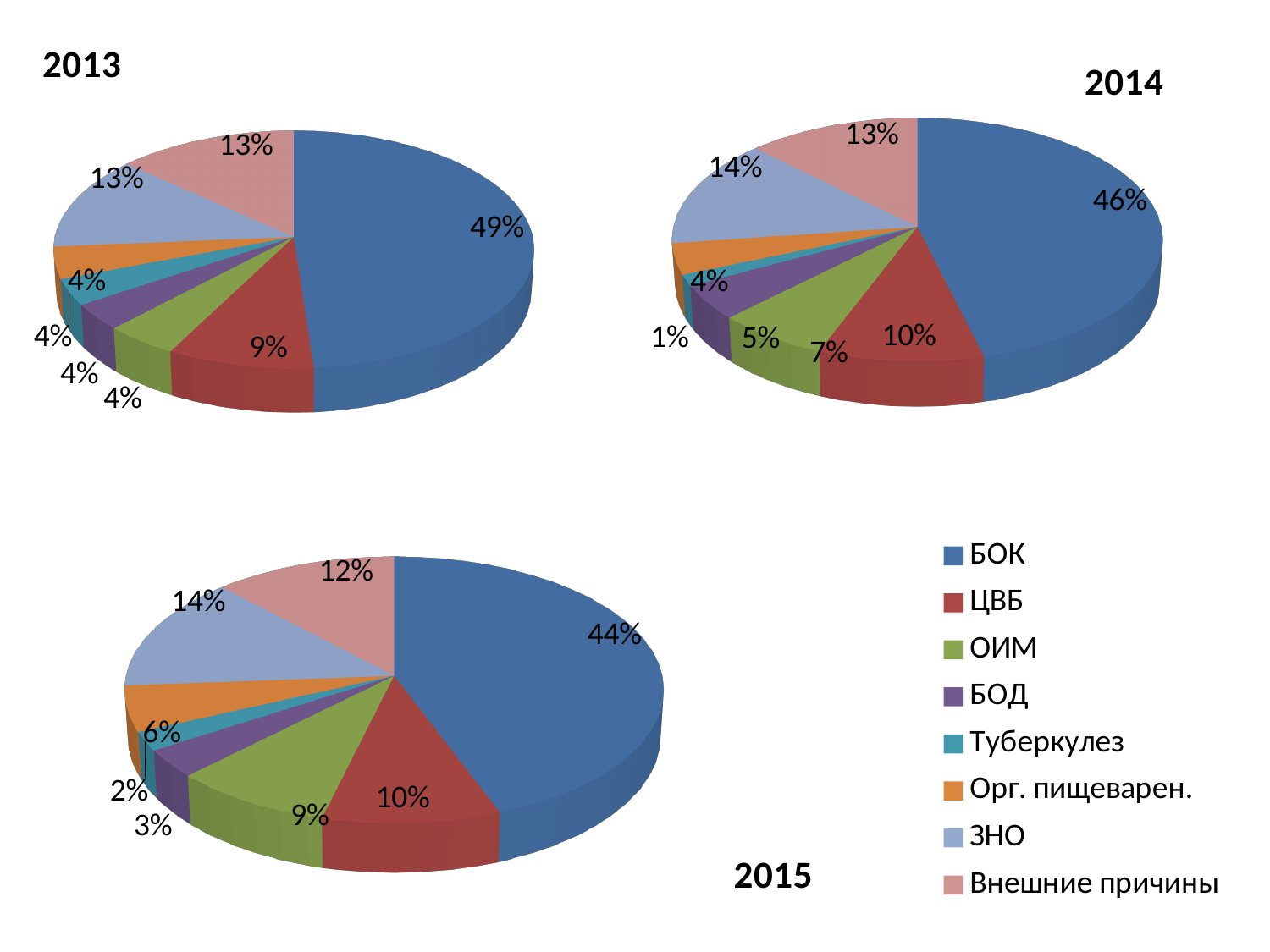
How many categories does the legend list? 8 What type of charts are shown on the slide? Pie charts In the 2014 pie chart, what share does ЗНО have? 14% In the 2015 pie chart, what share does Орг. пищеварен. have? 6% In the 2015 pie chart, what share does ЦВБ have? 10% In the 2014 pie chart, which category has the smallest share? Туберкулез In the 2015 pie chart, what is the difference between the shares of ЗНО and Внешние причины? 2% Which colour represents Внешние причины in the legend? Pink In the 2015 pie chart, which category has the largest share? БОК In the 2013 pie chart, what share does БОК have? 49% How does the share of БОК change from 2013 to 2015 across the three pie charts? It falls (49%, 46%, 44%) In the 2013 pie chart, which is larger: the share of ЦВБ or the share of ЗНО? ЗНО